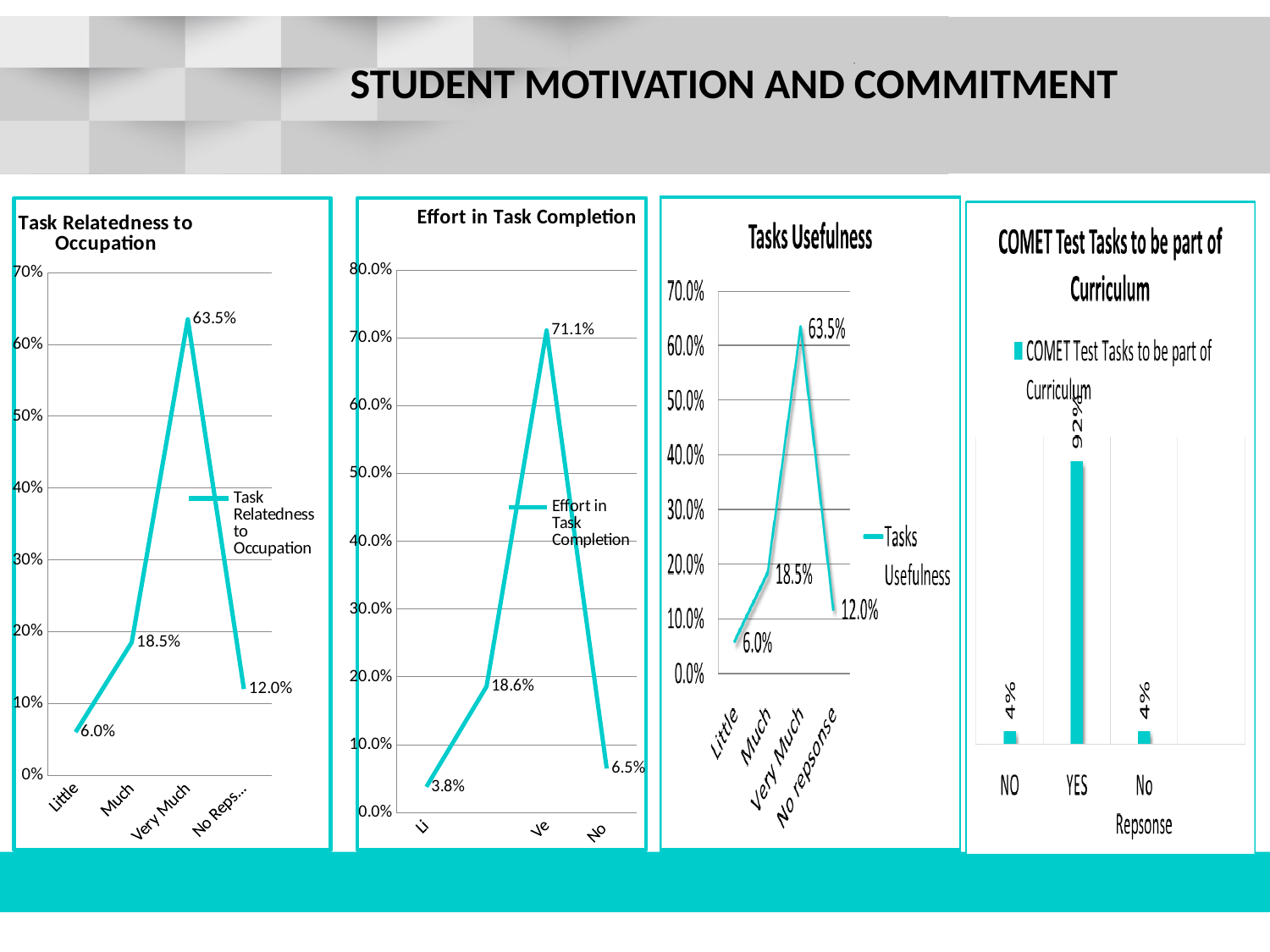
In the 'Task Relatedness to Occupation' chart, what is the value for Very Much? 63.5% In the 'Tasks Usefulness' chart, which category has the highest value? Very Much What kind of chart is the 'COMET Test Tasks to be part of Curriculum' chart? Bar chart What kind of chart is the 'Effort in Task Completion' chart? Line chart In the 'Task Relatedness to Occupation' chart, what is the value for Little? 6.0% In the 'COMET Test Tasks to be part of Curriculum' chart, what is the value for YES? 92% In the 'Task Relatedness to Occupation' chart, what is the difference between the values for Much and Little? 12.5% In the 'COMET Test Tasks to be part of Curriculum' chart, what is the difference between YES and NO? 88% In the 'Effort in Task Completion' chart, what is the lowest value shown? 3.8% In the 'Effort in Task Completion' chart, what is the highest value shown? 71.1% In the 'Tasks Usefulness' chart, how many categories are plotted? 4 In the 'Tasks Usefulness' chart, what is the value for Much? 18.5%